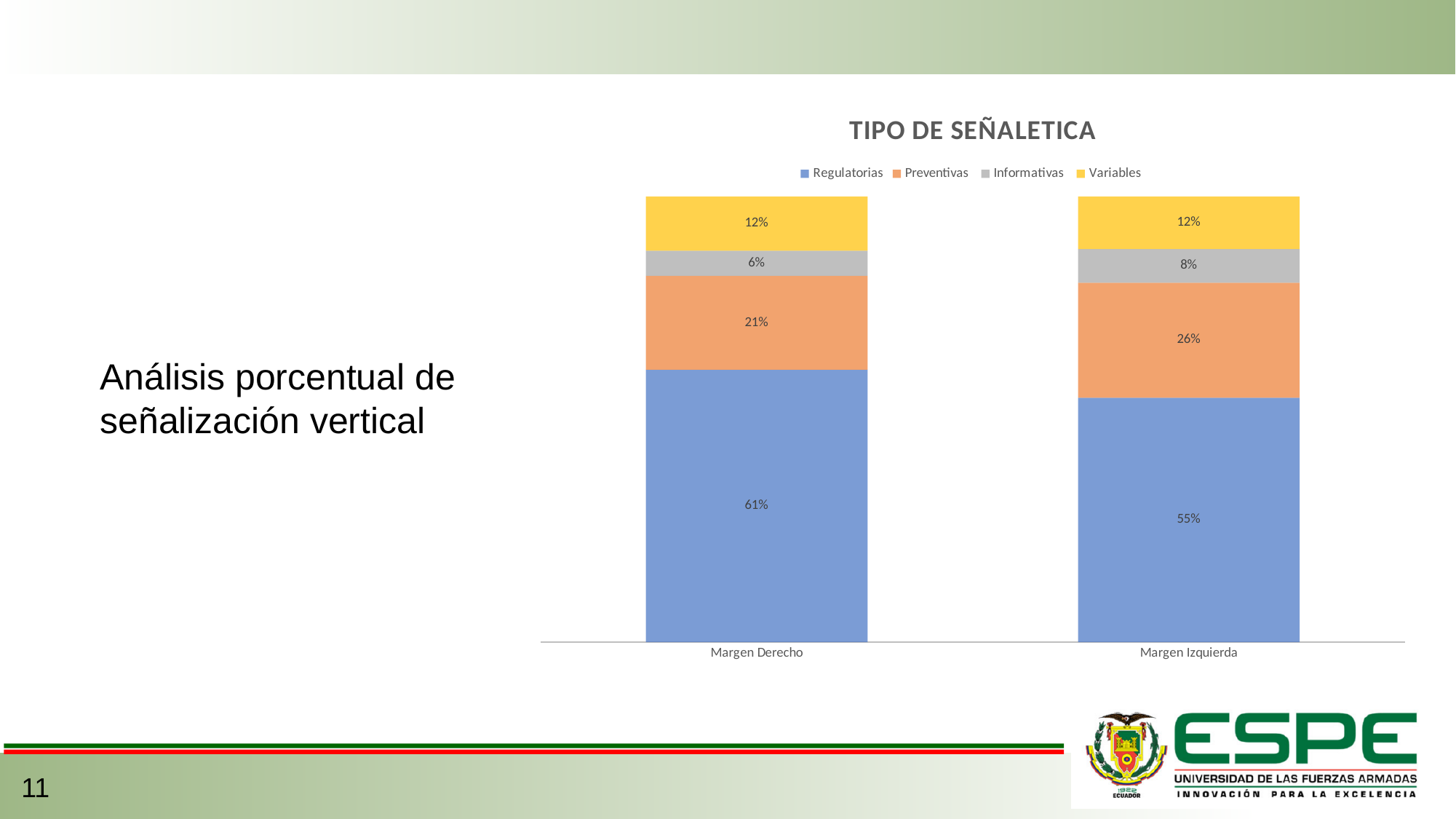
How many categories are shown on the x axis? 2 Which series has the largest share in the Margen Izquierda bar? Regulatorias What kind of chart is shown? Stacked bar chart Which series has the smallest share in the Margen Derecho bar? Informativas What is the value for Variables in Margen Izquierda? 12% What is the title of the chart? TIPO DE SEÑALETICA Which is larger: Preventivas in Margen Derecho or Preventivas in Margen Izquierda? Margen Izquierda What is the difference between the Regulatorias values for Margen Derecho and Margen Izquierda? 6% How many series does the legend list? 4 What is the value for Preventivas in Margen Izquierda? 26% What is the value for Informativas in Margen Derecho? 6% What is the value for Regulatorias in Margen Derecho? 61%